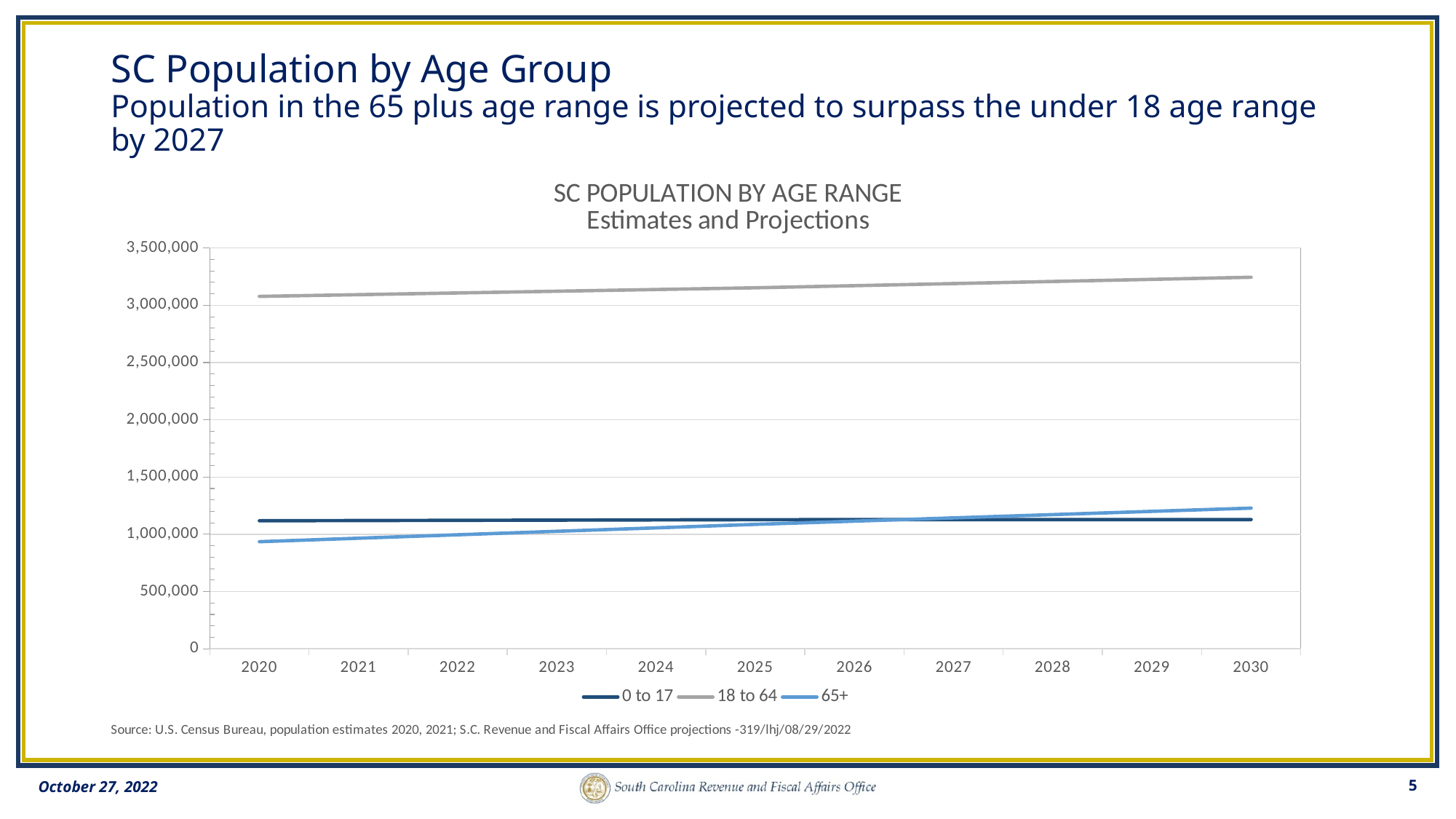
Which age range has the lowest population in 2020? 65+ Which age range has the highest population across all years shown? 18 to 64 What kind of chart is shown on the slide? Line chart Does the 65+ line rise or fall from 2020 to 2030? Rises Is the value for 65+ in 2020 greater or less than 1,000,000? less How many series does the legend list? 3 Is the value for 0 to 17 in 2030 greater or less than 1,000,000? greater In 2030, which is larger: the 65+ population or the 0 to 17 population? 65+ How many years are shown along the x axis? 11 What is the title of the chart? SC POPULATION BY AGE RANGE Estimates and Projections In 2020, which is larger: the 0 to 17 population or the 65+ population? 0 to 17 Is the value for 18 to 64 in 2020 greater or less than 3,000,000? greater